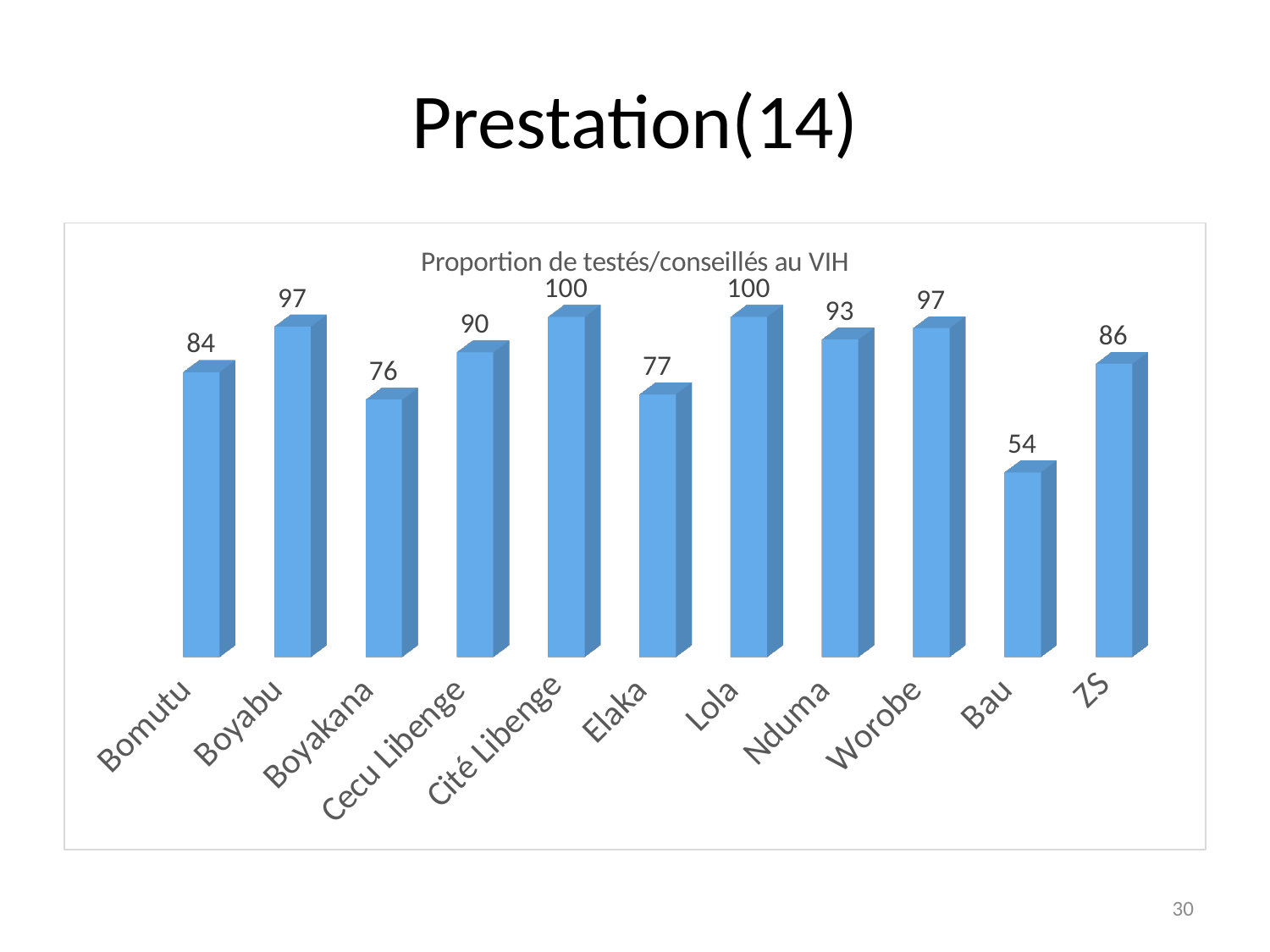
What is the value for Nduma? 93 Which is larger, the value for Elaka or the value for Worobe? Worobe Which categories share the highest value of 100? Cité Libenge and Lola What is the difference between the values for ZS and Bau? 32 What kind of chart is shown on the slide? Bar chart What is the difference between the values for Boyabu and Boyakana? 21 What is the value for Bau? 54 What is the value for Cecu Libenge? 90 Which category has the lowest value? Bau What is the value for Bomutu? 84 How many categories are shown on the x axis? 11 What is the title of the chart? Proportion de testés/conseillés au VIH